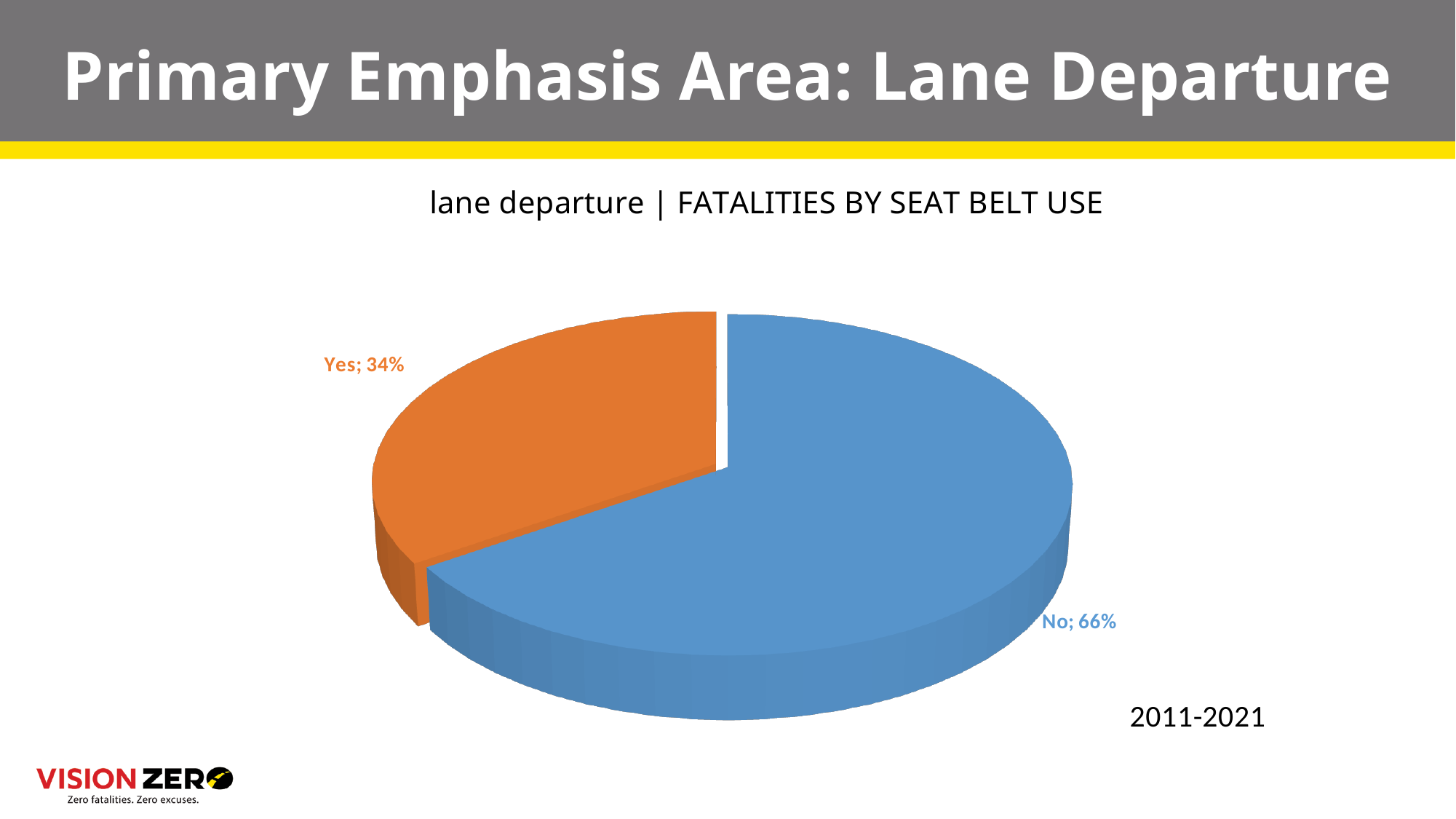
Which seat belt use category has the largest share of the pie? No What colour is the "Yes" slice of the pie chart? Orange How many slices does the pie chart have? 2 What is the title of the chart? lane departure | FATALITIES BY SEAT BELT USE Which seat belt use category has the smallest share of the pie? Yes What kind of chart is shown on the slide? Pie chart What is the difference in percentage points between the "No" and "Yes" slices? 32 What is the total of the two slice percentages shown on the pie chart? 100% Which slice is larger, "Yes" or "No"? No What share of lane departure fatalities were for seat belt use "No"? 66% What share of lane departure fatalities were for seat belt use "Yes"? 34%